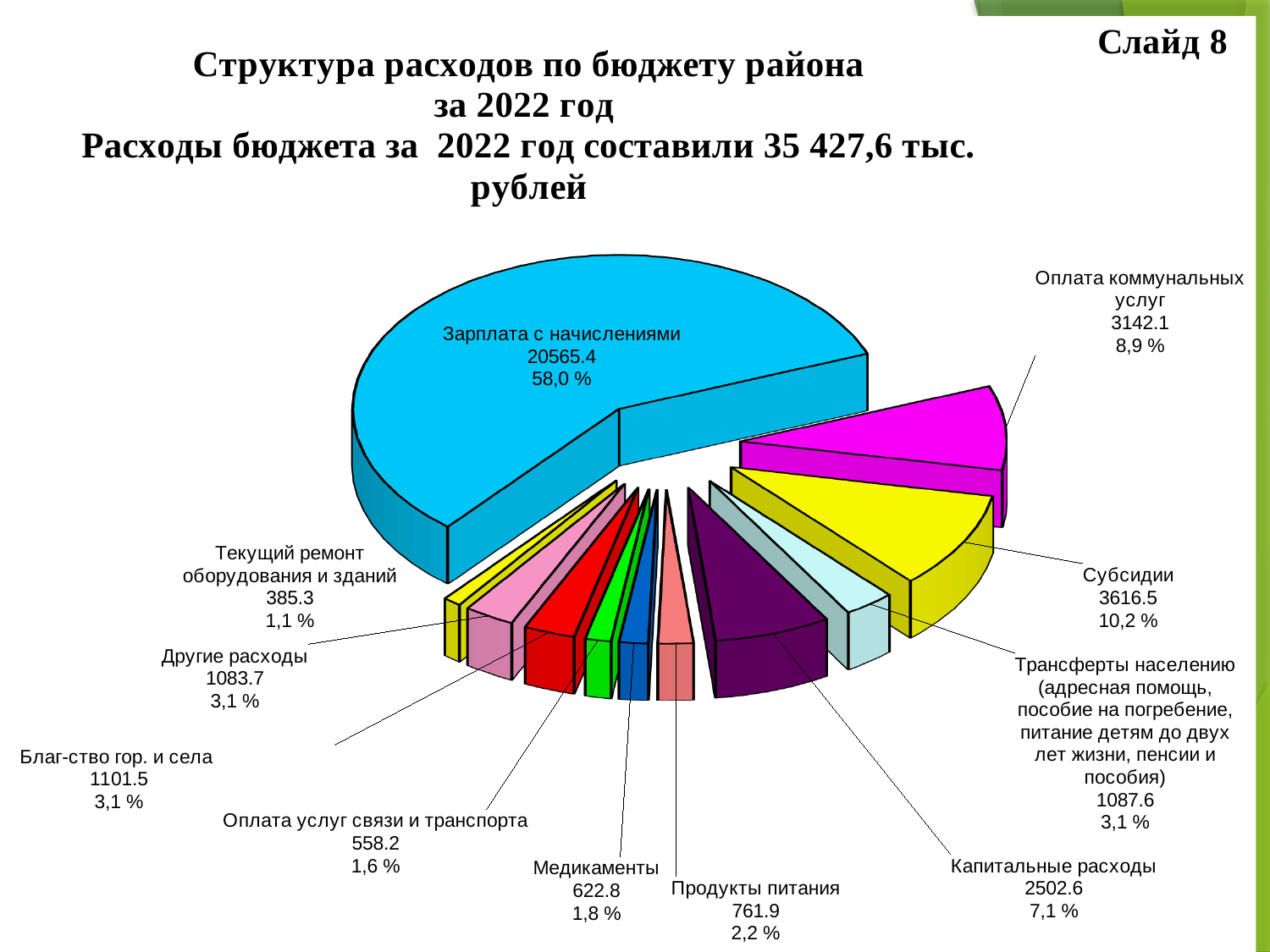
What is the difference between the values for Субсидии and Оплата коммунальных услуг? 474.4 What kind of chart is shown on the slide? pie chart What share of the pie does Продукты питания represent? 2,2 % What is the value shown for Субсидии? 3616.5 How many slices does the pie chart have? 11 What share of the pie does Оплата коммунальных услуг represent? 8,9 % What is the value shown for Зарплата с начислениями? 20565.4 What is the value shown for Капитальные расходы? 2502.6 Which category has the smallest slice of the pie? Текущий ремонт оборудования и зданий What total budget expenditure for 2022 is stated in the slide title? 35 427,6 тыс. рублей Which category has the largest slice of the pie? Зарплата с начислениями Which is larger, the value for Медикаменты or the value for Продукты питания? Продукты питания